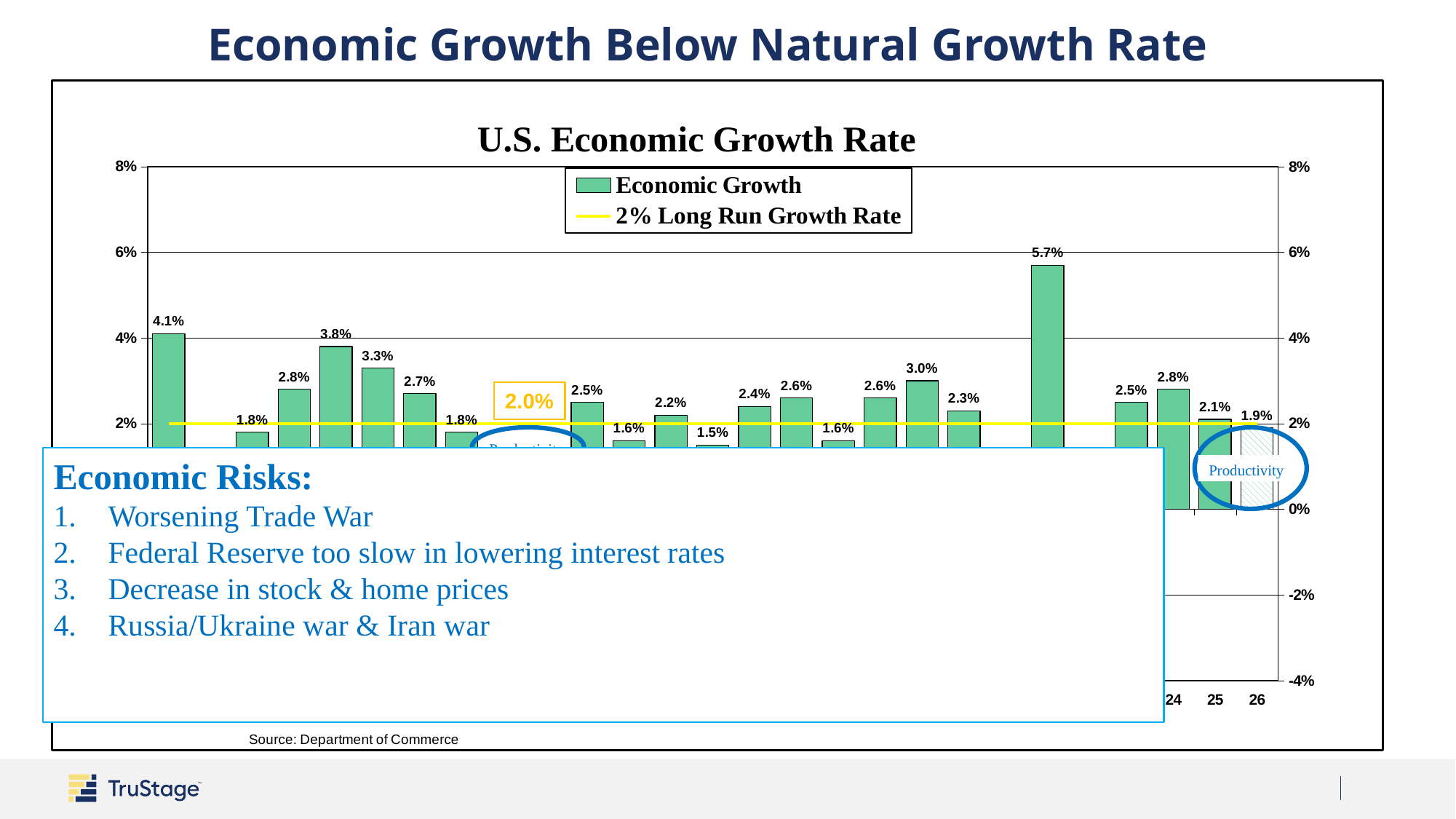
What is the economic growth rate shown for 24? 2.8% Is the economic growth rate for 26 greater or less than 2%? less What value does the yellow horizontal line represent according to the legend? 2% Long Run Growth Rate What is the economic growth rate shown for 25? 2.1% What is the title of the chart on the slide? U.S. Economic Growth Rate What kind of chart is used to show Economic Growth? bar chart What is the highest economic growth rate value labeled on the chart? 5.7% Which is larger, the economic growth rate for 25 or for 26? 25 What is the economic growth rate shown for 26? 1.9% What is the difference between the economic growth rate for 24 and for 25? 0.7% How many series does the chart legend list? 2 Do the economic growth values rise or fall from 24 to 26? fall